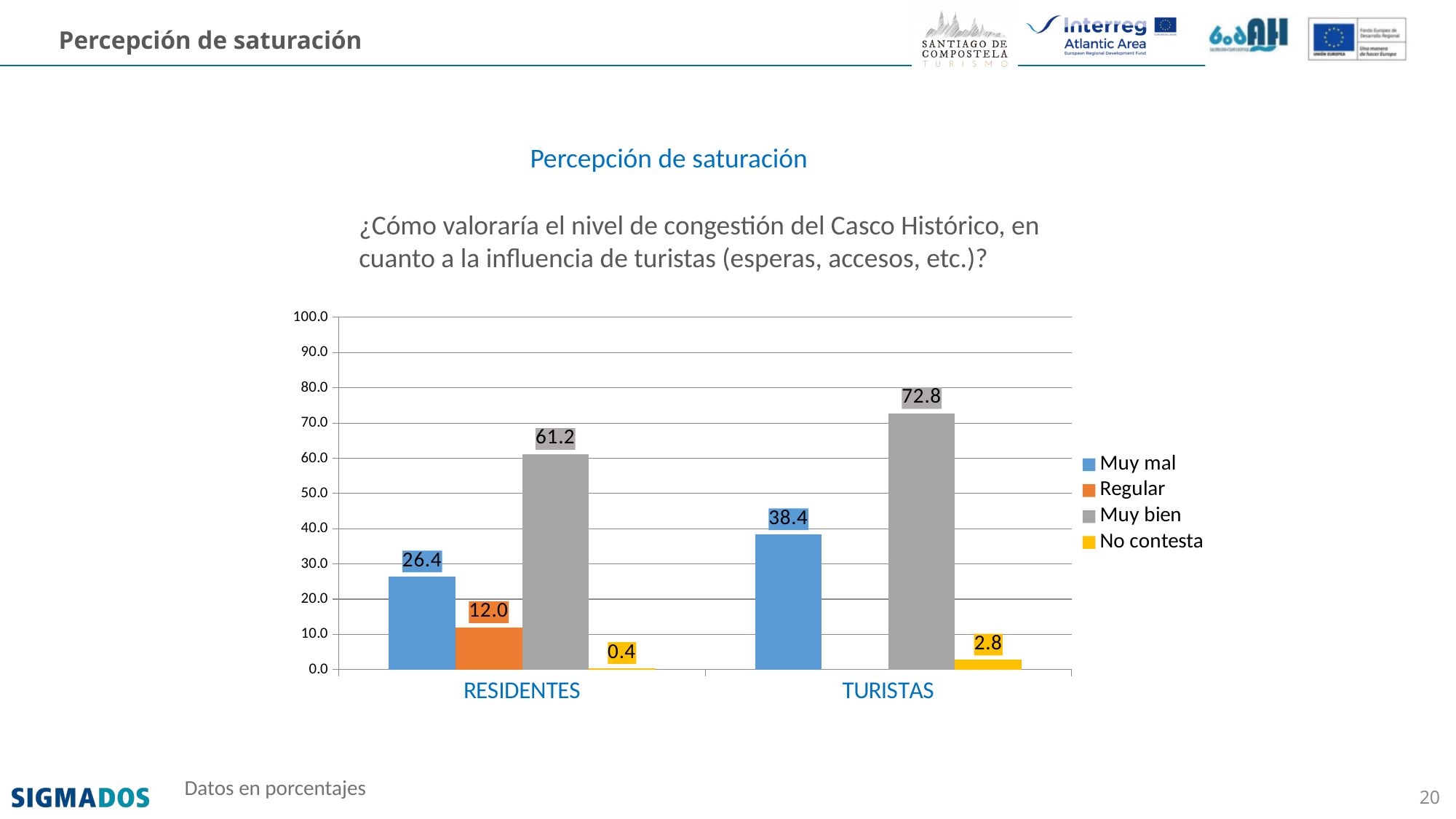
What is the value for Muy mal among TURISTAS? 38.4 What is the value for Regular among RESIDENTES? 12.0 Which series has the highest value for TURISTAS? Muy bien Which group has the larger Muy mal value, RESIDENTES or TURISTAS? TURISTAS What is the value for Muy bien among RESIDENTES? 61.2 What is the value for No contesta among TURISTAS? 2.8 What colour represents the Muy bien series in the chart? Grey Is the Muy bien value for RESIDENTES greater or less than 50.0? greater What kind of chart is shown on the slide? Bar chart How many series does the legend list? 4 What is the difference between the Muy bien values for TURISTAS and RESIDENTES? 11.6 Which series has the lowest value for RESIDENTES? No contesta